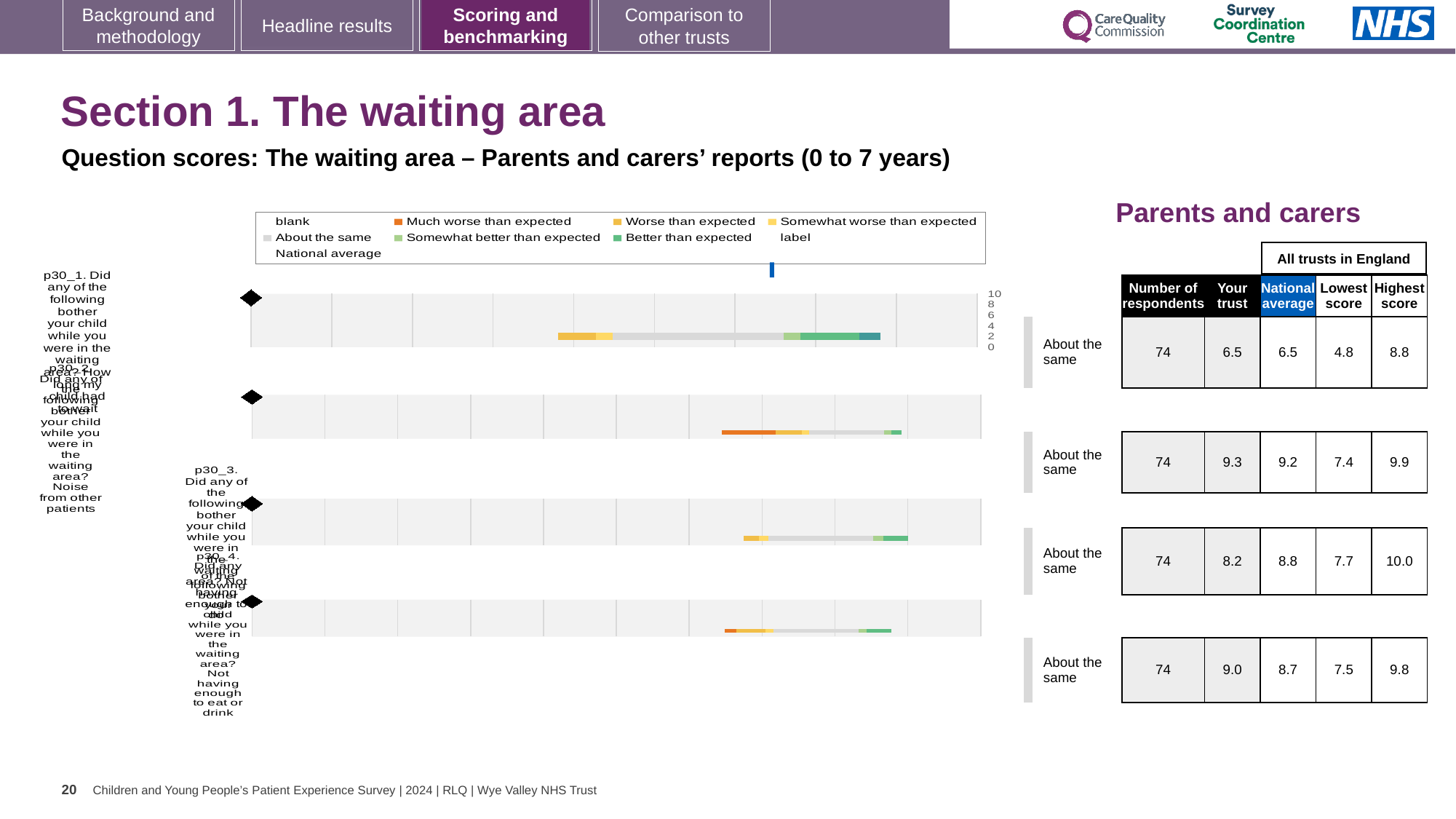
In the table to the right of the chart, what is the highest score for the fourth row? 9.8 In the table to the right of the chart, for the third row, which is larger: the 'Your trust' score or the national average? National average In the table to the right of the chart, which row has the highest 'Your trust' score? second row (9.3) How many question bars are plotted in the chart? 4 In the table to the right of the chart, what is the 'Your trust' score for the second row? 9.3 In the table to the right of the chart, what is the difference between the highest score and the lowest score in the first row? 4.0 In the table to the right of the chart, what is the number of respondents for the first row? 74 What benchmark label is shown next to each of the four bars in the chart? About the same In the chart legend, what colour represents 'Better than expected'? green In the chart legend, what colour represents 'Much worse than expected'? orange What kind of chart is shown on the slide? bar chart In the table to the right of the chart, what is the national average for the third row? 8.8